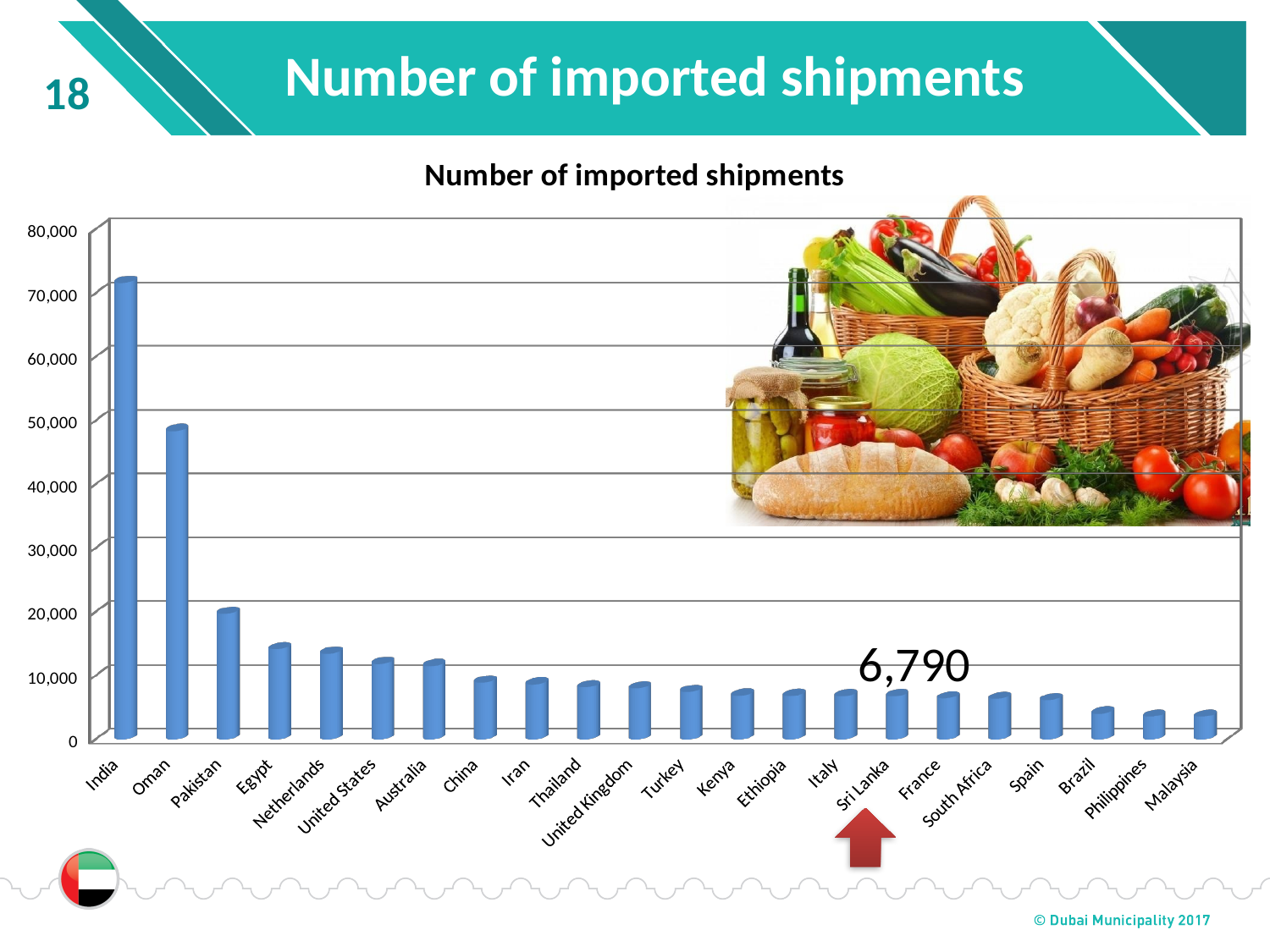
Is the value for Turkey greater or less than 10,000? less Is the value for Oman greater or less than 40,000? greater What is the number of imported shipments for Sri Lanka? 6,790 Do the values generally rise or fall from left to right along the x axis? Fall What kind of chart is shown on the slide? Bar chart How many countries are shown on the x axis of the chart? 22 Which has more imported shipments, Pakistan or Egypt? Pakistan Which country does the red arrow below the chart point to? Sri Lanka Which country has the highest number of imported shipments? India Is the value for Egypt greater or less than 20,000? less Which has more imported shipments, India or Oman? India